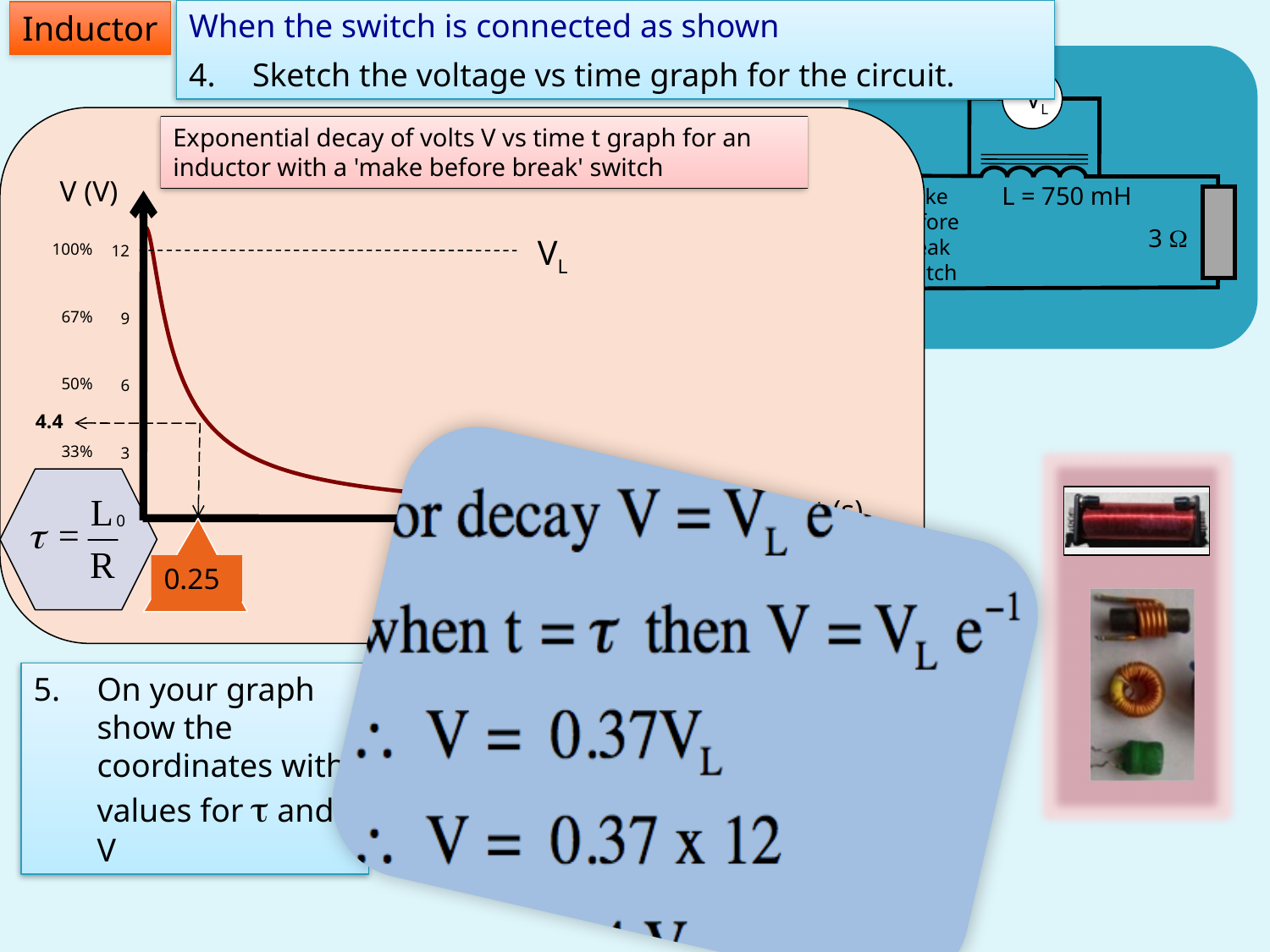
Is the voltage at t = 0.25 greater or less than 6? less What is the difference between V_L (12) and the voltage marked at t = 0.25 (4.4)? 7.6 What voltage value is marked on the graph at t = 0.25? 4.4 What percentage label is shown next to the vertical axis value 6? 50% What voltage value does the dashed horizontal line labelled V_L correspond to on the graph? 12 Is the voltage at t = 0.25 greater or less than 3? greater At what time value is the voltage of 4.4 marked on the graph? 0.25 What is the title of the graph? Exponential decay of volts V vs time t graph for an inductor with a 'make before break' switch Do the voltage values rise or fall as time increases along the x axis of the graph? fall How many numbered tick marks are shown on the vertical axis of the graph? 4 What kind of chart is the voltage vs time graph on the slide? line chart What is the label on the vertical axis of the graph? V (V)